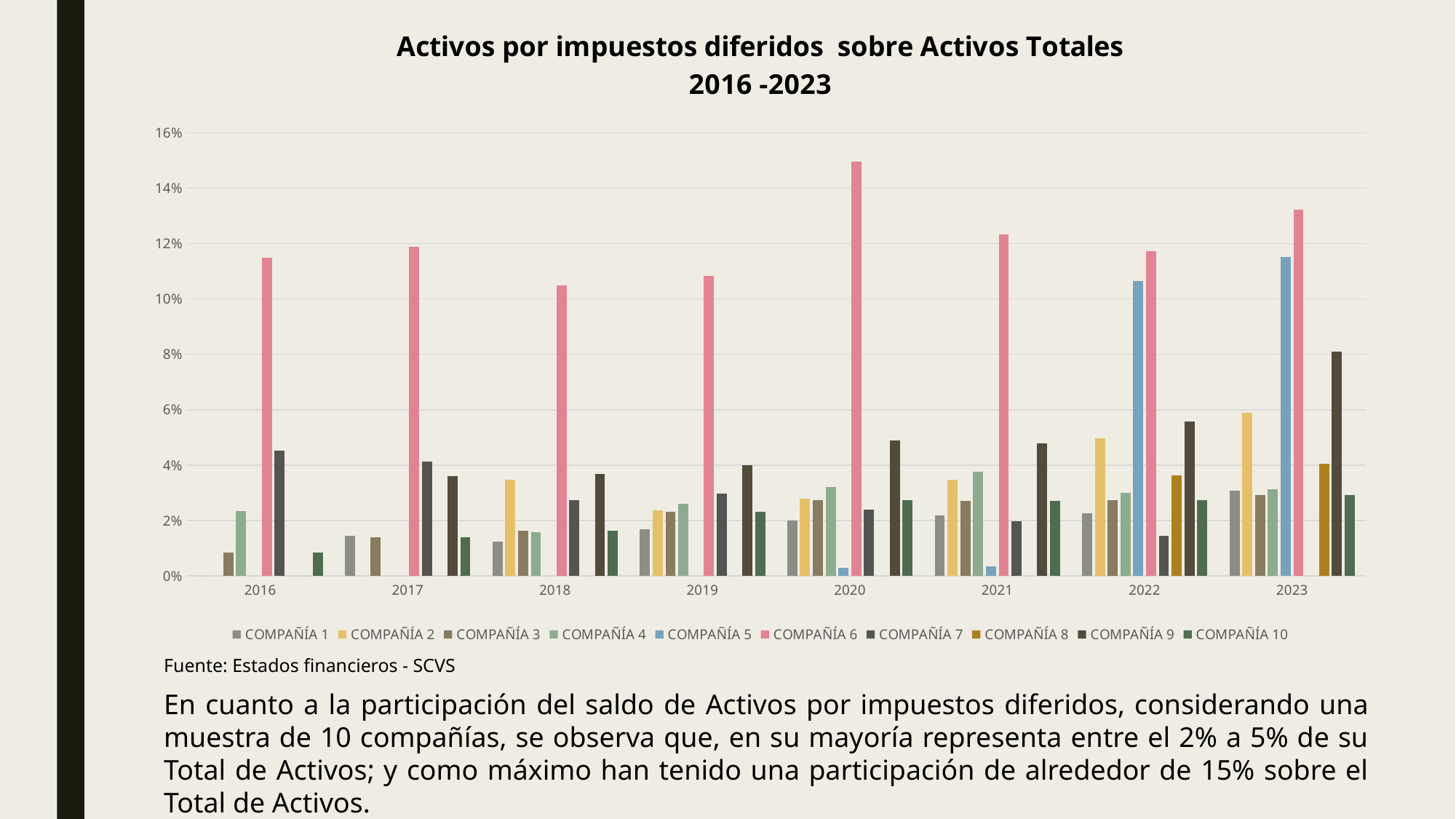
How many series does the legend list? 10 Is the value for COMPAÑÍA 9 in 2023 greater or less than 6%? greater Do the values for COMPAÑÍA 5 rise or fall from 2020 to 2023? rise For COMPAÑÍA 6, which is larger: the value in 2021 or the value in 2022? 2021 What is the title of the chart? Activos por impuestos diferidos sobre Activos Totales 2016 -2023 In 2023, which is larger: the value for COMPAÑÍA 6 or the value for COMPAÑÍA 5? COMPAÑÍA 6 In which year does COMPAÑÍA 6 reach its highest value? 2020 How many years are shown on the x axis? 8 Is the value for COMPAÑÍA 5 in 2023 greater or less than 10%? greater Is the value for COMPAÑÍA 2 in 2023 greater or less than 4%? greater What kind of chart is shown on the slide? bar chart